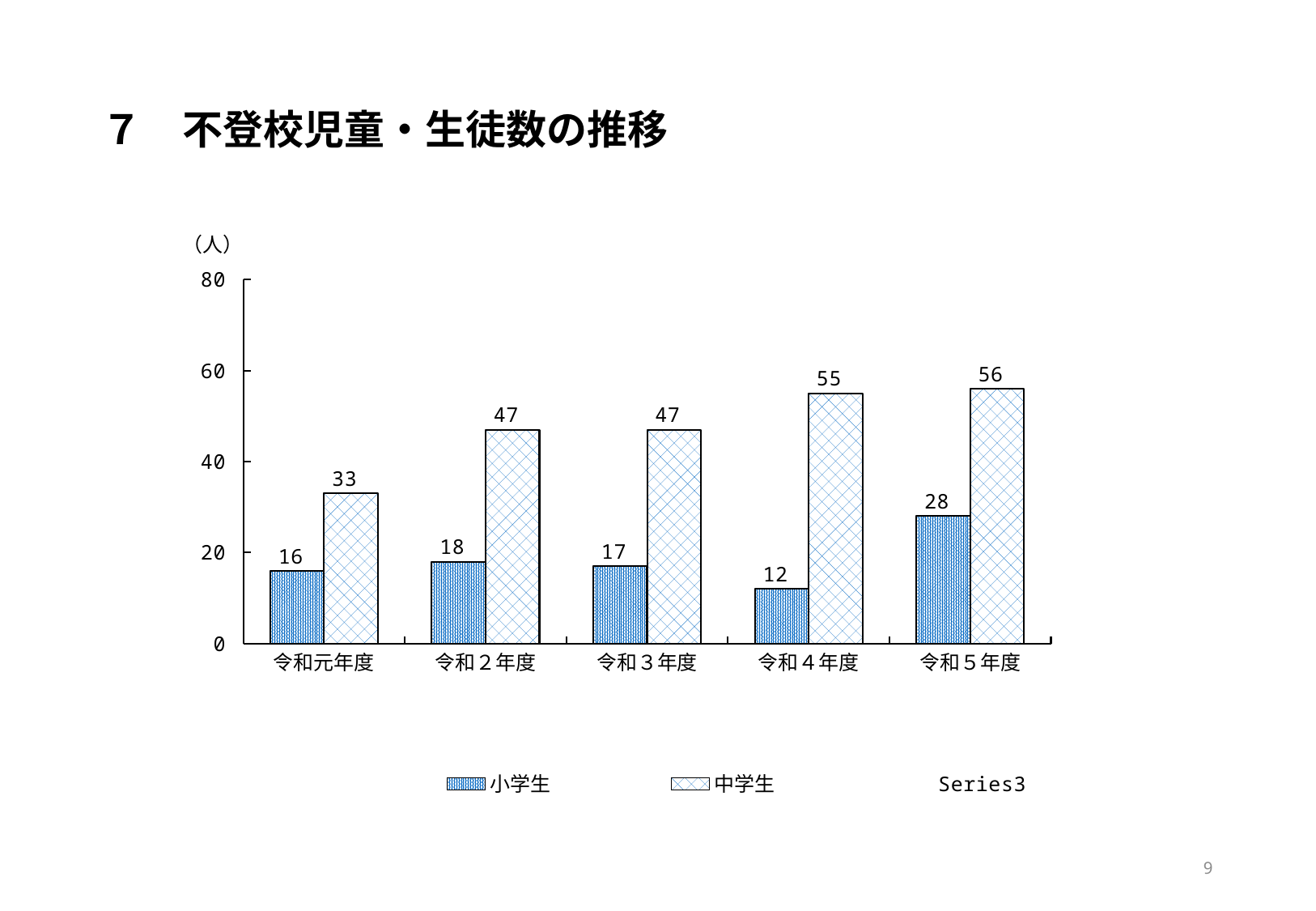
How many year categories are shown on the x axis? 5 What is the value for 中学生 in 令和元年度? 33 What is the difference between the 中学生 value and the 小学生 value in 令和２年度? 29 What unit is shown above the vertical axis? （人） Which year has the lowest value for 中学生? 令和元年度 Which year has the highest value for 小学生? 令和５年度 What kind of chart is shown on the slide? bar chart How many series does the legend list? 3 Which is larger in 令和３年度, the 小学生 value or the 中学生 value? 中学生 What is the value for 中学生 in 令和５年度? 56 Is the value for 中学生 in 令和４年度 greater or less than 40? greater What is the value for 小学生 in 令和４年度? 12